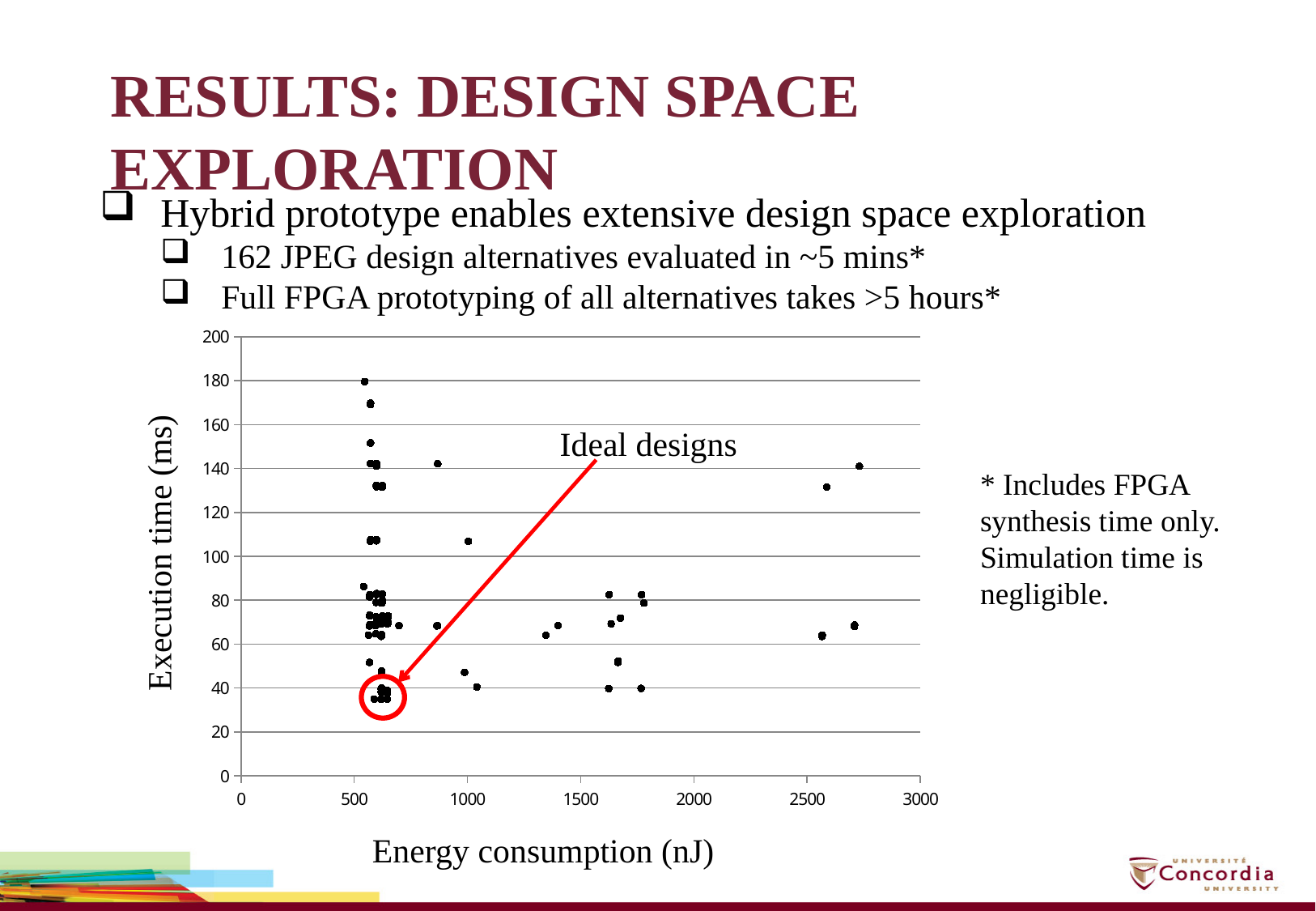
Is the energy consumption of the points circled as "Ideal designs" greater or less than 1000? less What text does the red arrow annotation on the chart point to the circled points with? Ideal designs What is the label of the vertical axis of the chart? Execution time (ms) Is the energy consumption of the rightmost point on the chart greater or less than 2500? greater Is the execution time of the highest point on the chart greater or less than 160? greater What kind of chart is shown on the slide? scatter chart